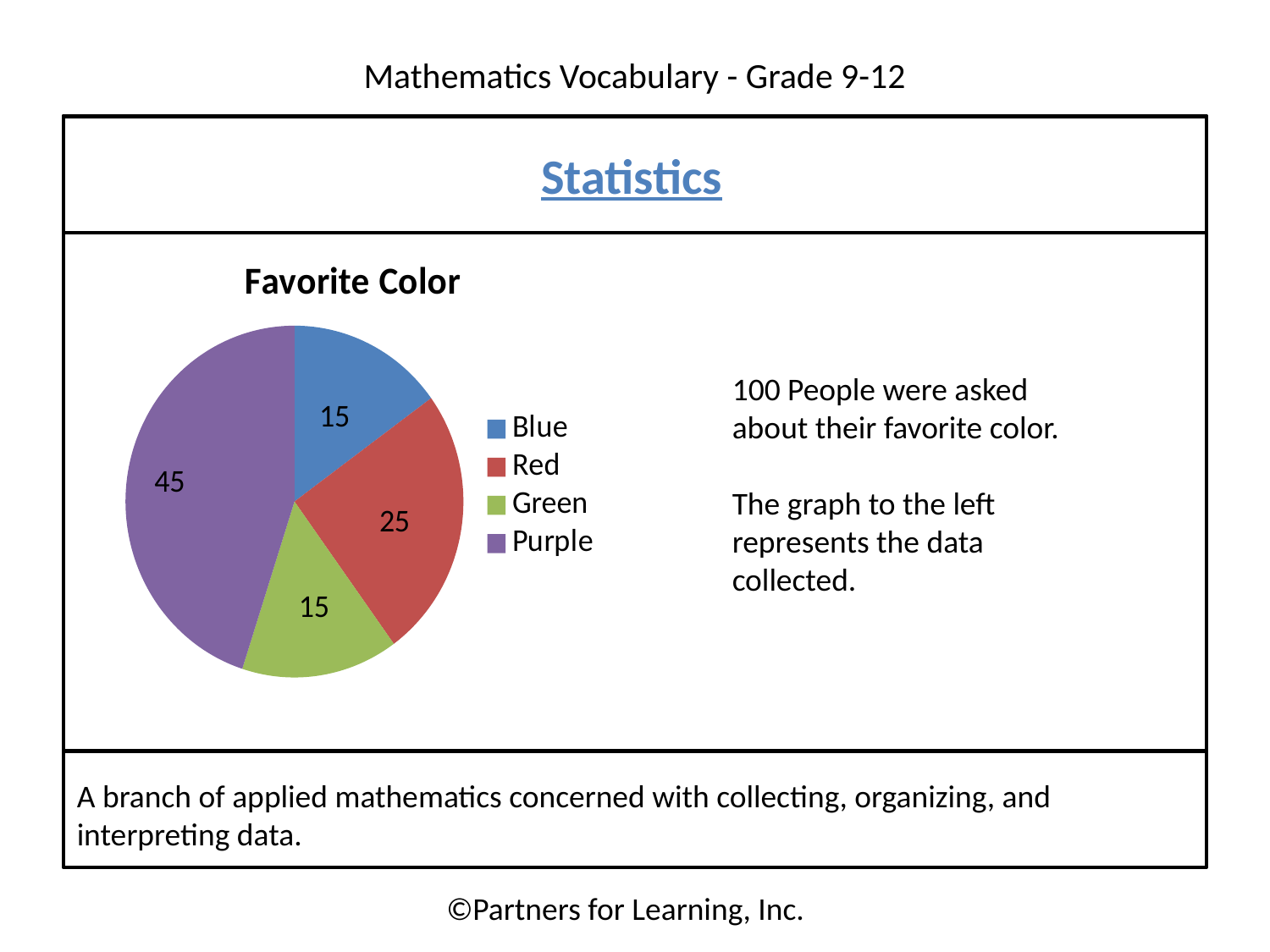
Which legend entry is listed last in the Favorite Color pie chart? Purple What is the value for Blue in the Favorite Color pie chart? 15 What share of the Favorite Color pie does Red represent? 25% What is the difference between the values for Purple and Red in the Favorite Color pie chart? 20 Which color has the largest slice in the Favorite Color pie chart? Purple What is the value for Red in the Favorite Color pie chart? 25 What is the value for Purple in the Favorite Color pie chart? 45 What is the title of the pie chart on the slide? Favorite Color What share of the Favorite Color pie does Purple represent? 45% Which is larger in the Favorite Color pie chart, Red or Green? Red How many categories are shown in the Favorite Color pie chart? 4 What kind of chart is shown on the slide? Pie chart